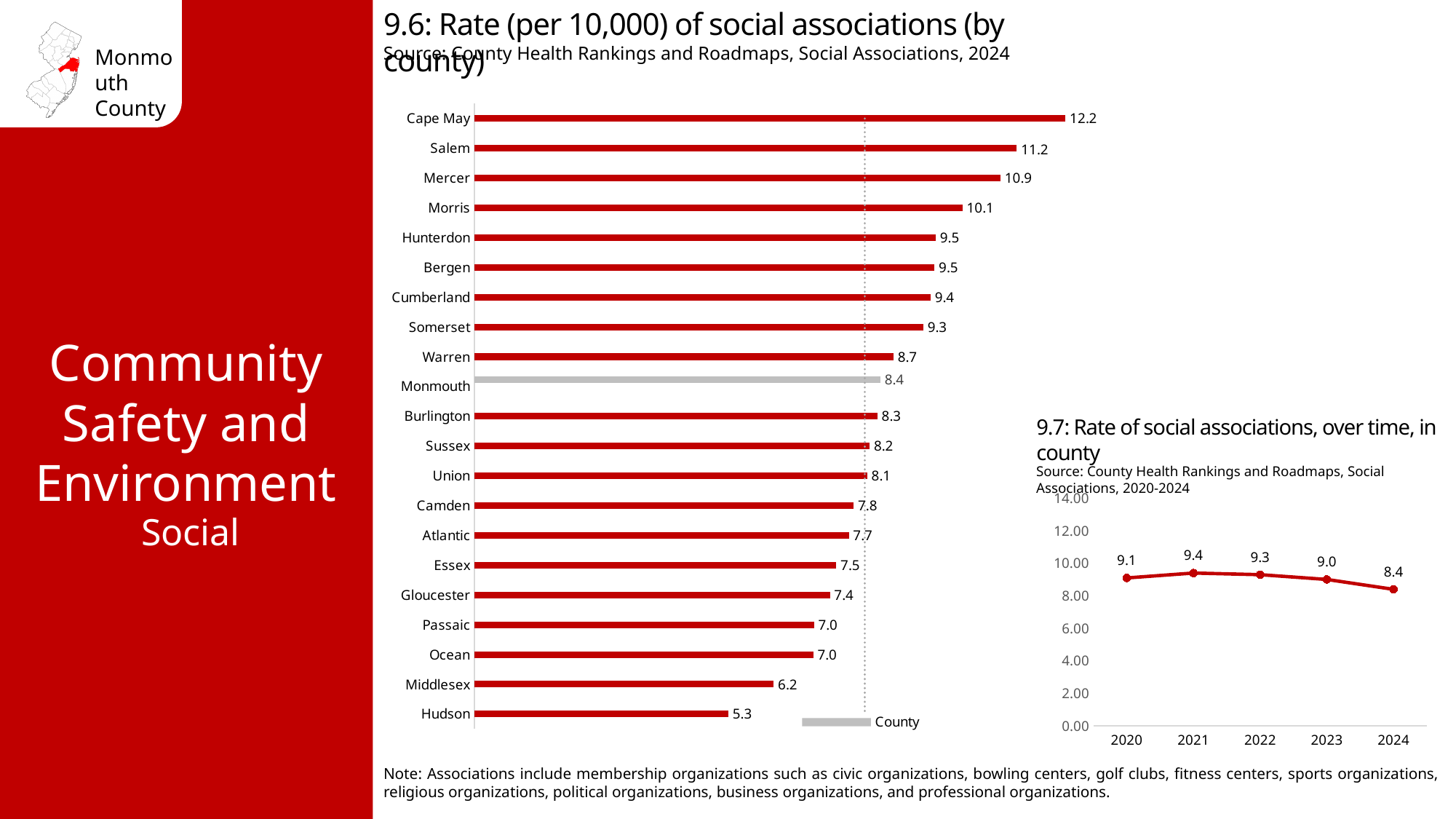
In chart 9.6 (rate of social associations by county), what is the value for Middlesex? 6.2 In chart 9.6 (rate of social associations by county), how many counties are plotted? 21 In chart 9.7 (rate of social associations over time), what is the value for 2021? 9.4 In chart 9.6 (rate of social associations by county), which county has the highest rate? Cape May In chart 9.6 (rate of social associations by county), what is the difference between Cape May and Hudson? 6.9 In chart 9.7 (rate of social associations over time), what is the difference between the 2021 and 2024 values? 1.0 In chart 9.6 (rate of social associations by county), which county has the lowest rate? Hudson In chart 9.7 (rate of social associations over time), which year has the lowest value? 2024 What kind of chart is chart 9.6 (rate of social associations by county)? Bar chart What kind of chart is chart 9.7 (rate of social associations over time)? Line chart In chart 9.6 (rate of social associations by county), what is the value for Monmouth? 8.4 In chart 9.6 (rate of social associations by county), which is larger, the value for Mercer or the value for Morris? Mercer